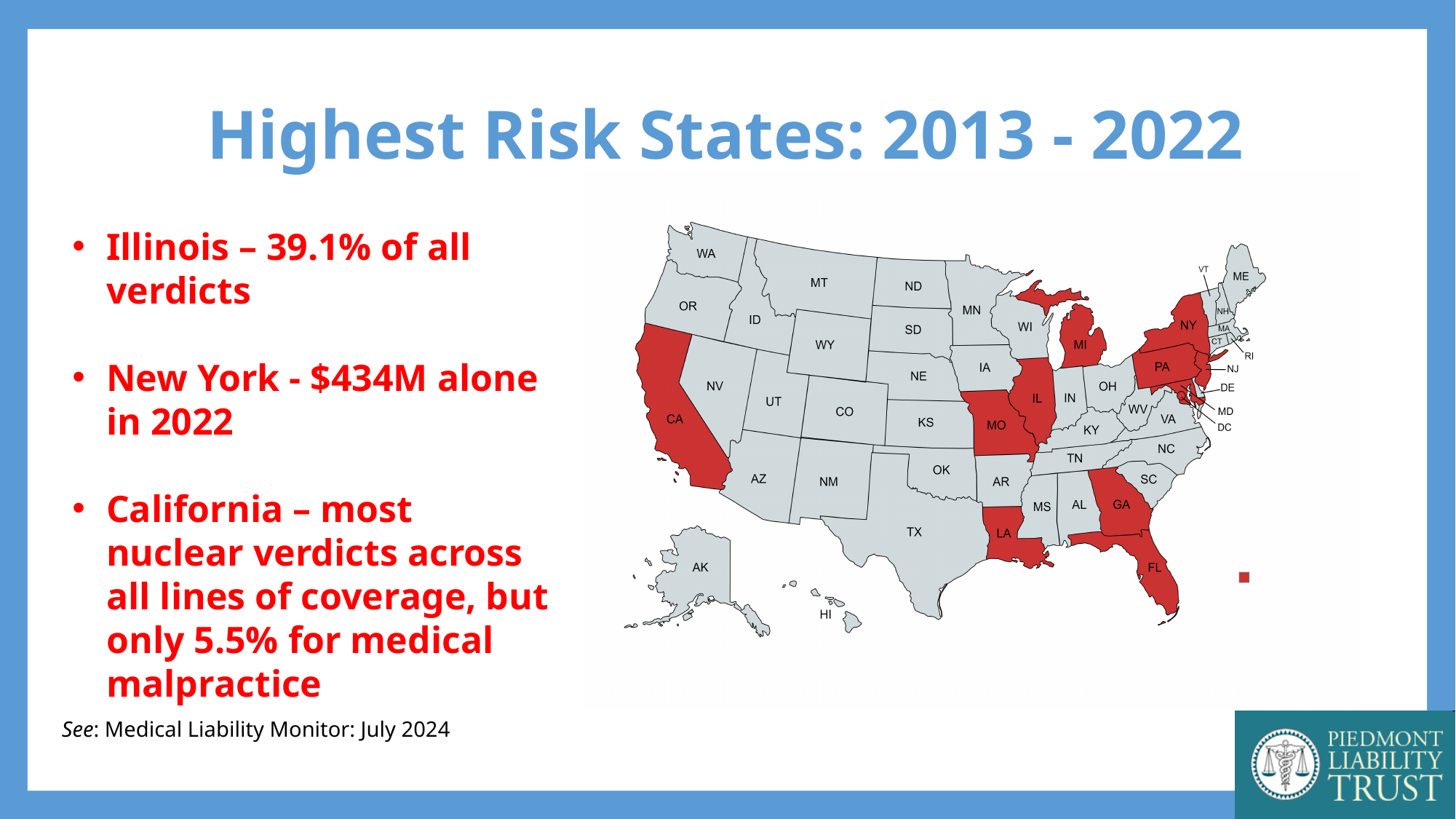
What kind of chart is shown on the right side of the slide? A map of the United States Is Florida (FL) highlighted as a highest risk state on the map? Yes Is Alaska (AK) shown as a highest risk state on the map? No What colour is used on the map to highlight the highest risk states? Red Which of the two states, Illinois (IL) or Indiana (IN), is highlighted in red on the map? Illinois (IL) Is Ohio (OH) highlighted in red on the map? No Which highlighted state on the map is described on the slide as having 39.1% of all verdicts? Illinois According to the slide, what verdict amount is attributed to New York alone in 2022? $434M What is the title of the slide containing the map? Highest Risk States: 2013 - 2022 Is California (CA) highlighted in red on the map? Yes According to the slide, what percentage of California's nuclear verdicts are for medical malpractice? 5.5% Is Texas (TX) highlighted as a highest risk state on the map? No